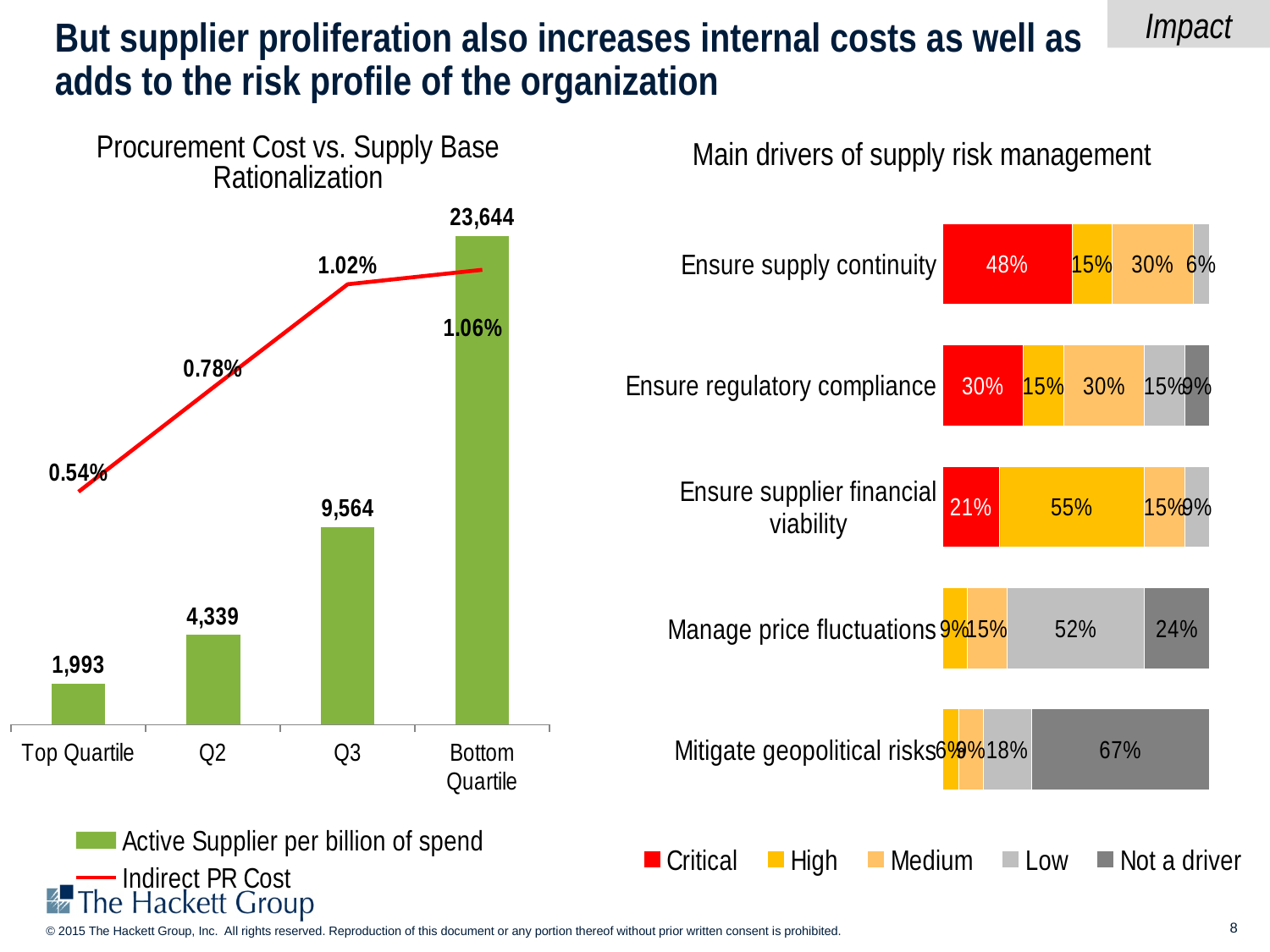
In the 'Main drivers of supply risk management' chart, which driver has the largest Critical share? Ensure supply continuity In the 'Procurement Cost vs. Supply Base Rationalization' chart, which category has the lowest Active Supplier per billion of spend? Top Quartile How many categories are shown on the x axis of the 'Procurement Cost vs. Supply Base Rationalization' chart? 4 What kind of chart is the 'Main drivers of supply risk management' chart? stacked bar chart In the 'Main drivers of supply risk management' chart, what percentage rated 'Ensure supply continuity' as Critical? 48% In the 'Procurement Cost vs. Supply Base Rationalization' chart, what is the Active Supplier per billion of spend value for the Bottom Quartile? 23,644 In the 'Main drivers of supply risk management' chart, is the High share for 'Ensure supplier financial viability' larger or smaller than the High share for 'Manage price fluctuations'? larger In the 'Procurement Cost vs. Supply Base Rationalization' chart, what is the Indirect PR Cost for Q2? 0.78% How many series does the legend of the 'Main drivers of supply risk management' chart list? 5 In the 'Procurement Cost vs. Supply Base Rationalization' chart, does the Indirect PR Cost rise or fall from Top Quartile to Bottom Quartile? rise In the 'Procurement Cost vs. Supply Base Rationalization' chart, what is the difference in Active Supplier per billion of spend between Q3 and Q2? 5,225 In the 'Main drivers of supply risk management' chart, what percentage rated 'Mitigate geopolitical risks' as Not a driver? 67%